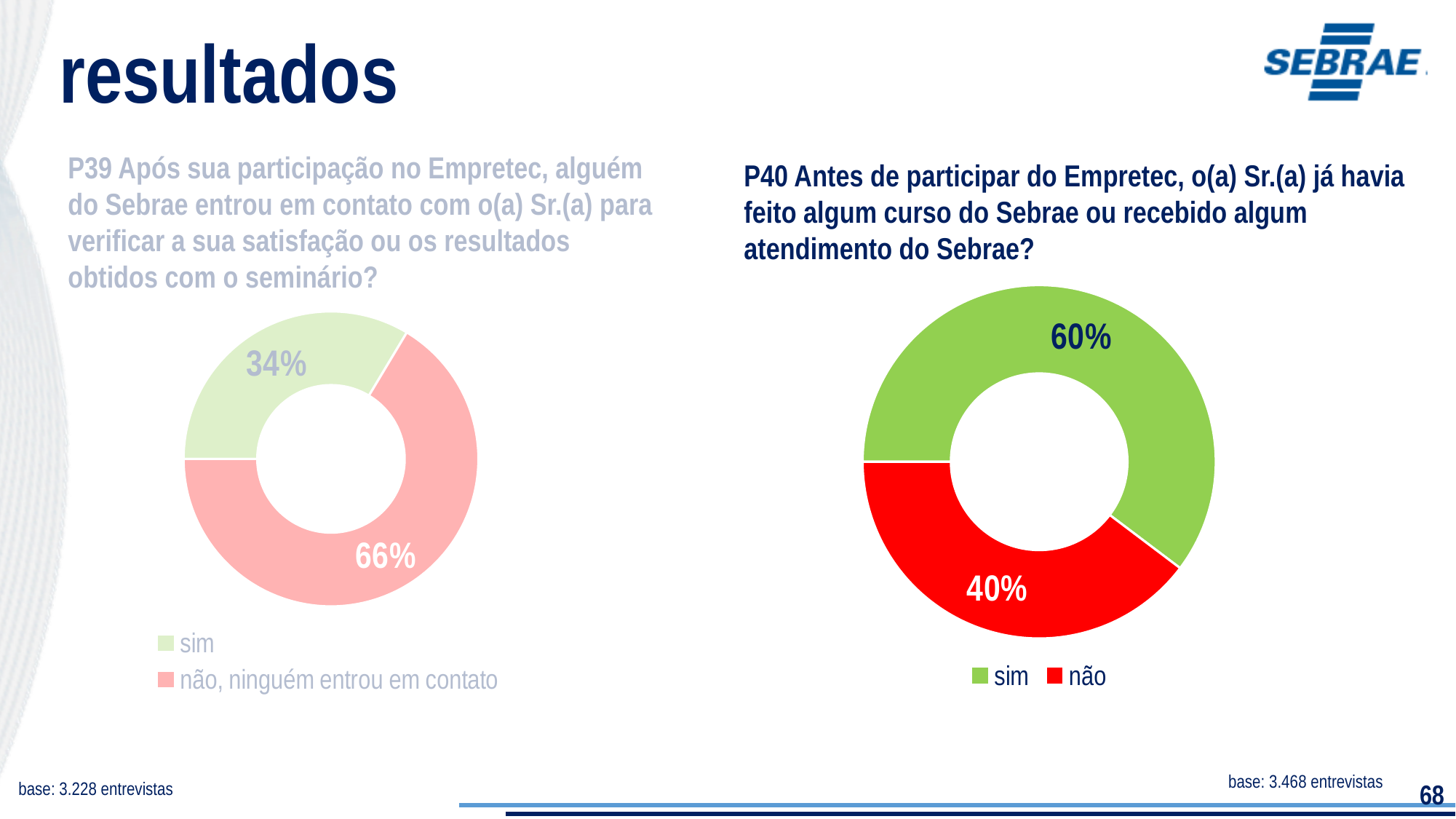
In the P40 chart on the right, which is larger, 'sim' or 'não'? sim In the P39 chart on the left, what percentage is shown for 'sim'? 34% In the P39 chart on the left, what is the difference between the 'não, ninguém entrou em contato' share and the 'sim' share? 32% In the P40 chart on the right, which category has the smallest share? não In the P40 chart on the right, what percentage is shown for 'sim'? 60% In the P40 chart on the right, what percentage is shown for 'não'? 40% In the P39 chart on the left, what percentage is shown for 'não, ninguém entrou em contato'? 66% In the P39 chart on the left, which category has the largest share? não, ninguém entrou em contato How many categories does the legend of the P39 chart on the left list? 2 In the P40 chart on the right, what colour is the 'não' slice? Red In the P40 chart on the right, what is the difference between the 'sim' share and the 'não' share? 20% What kind of chart is the P40 chart on the right? Doughnut chart